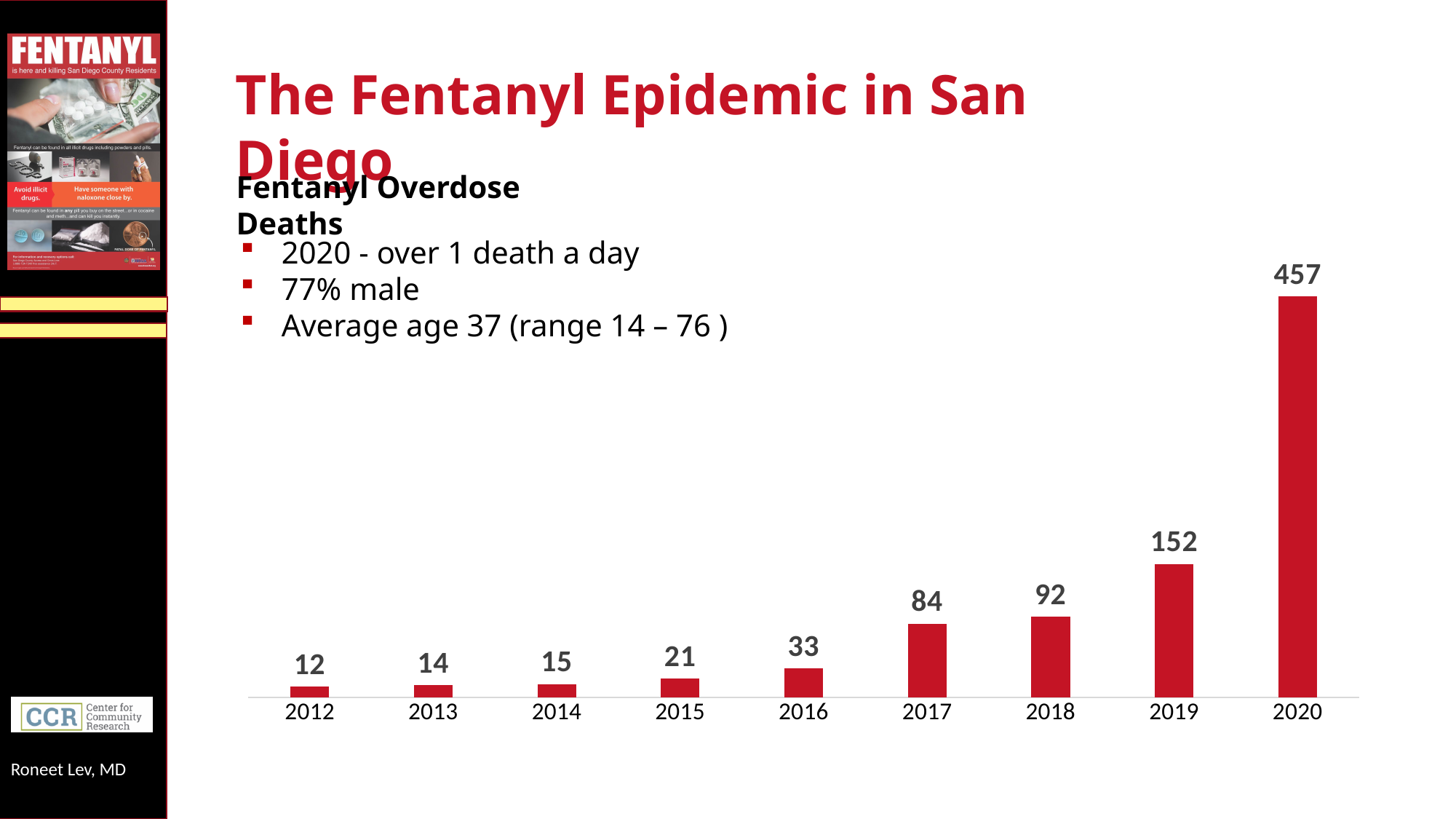
Which year has the highest value in the Fentanyl Overdose Deaths chart? 2020 What is the value for 2016 in the Fentanyl Overdose Deaths chart? 33 What kind of chart is the Fentanyl Overdose Deaths chart? bar chart What is the difference between the values for 2017 and 2016 in the Fentanyl Overdose Deaths chart? 51 How many years are shown on the x axis of the Fentanyl Overdose Deaths chart? 9 What is the value for 2018 in the Fentanyl Overdose Deaths chart? 92 What is the difference between the values for 2020 and 2019 in the Fentanyl Overdose Deaths chart? 305 What is the value for 2020 in the Fentanyl Overdose Deaths chart? 457 Which is larger in the Fentanyl Overdose Deaths chart, the value for 2015 or the value for 2017? 2017 Do the values in the Fentanyl Overdose Deaths chart rise or fall from 2012 to 2020? rise What colour are the bars in the Fentanyl Overdose Deaths chart? red Which year has the lowest value in the Fentanyl Overdose Deaths chart? 2012